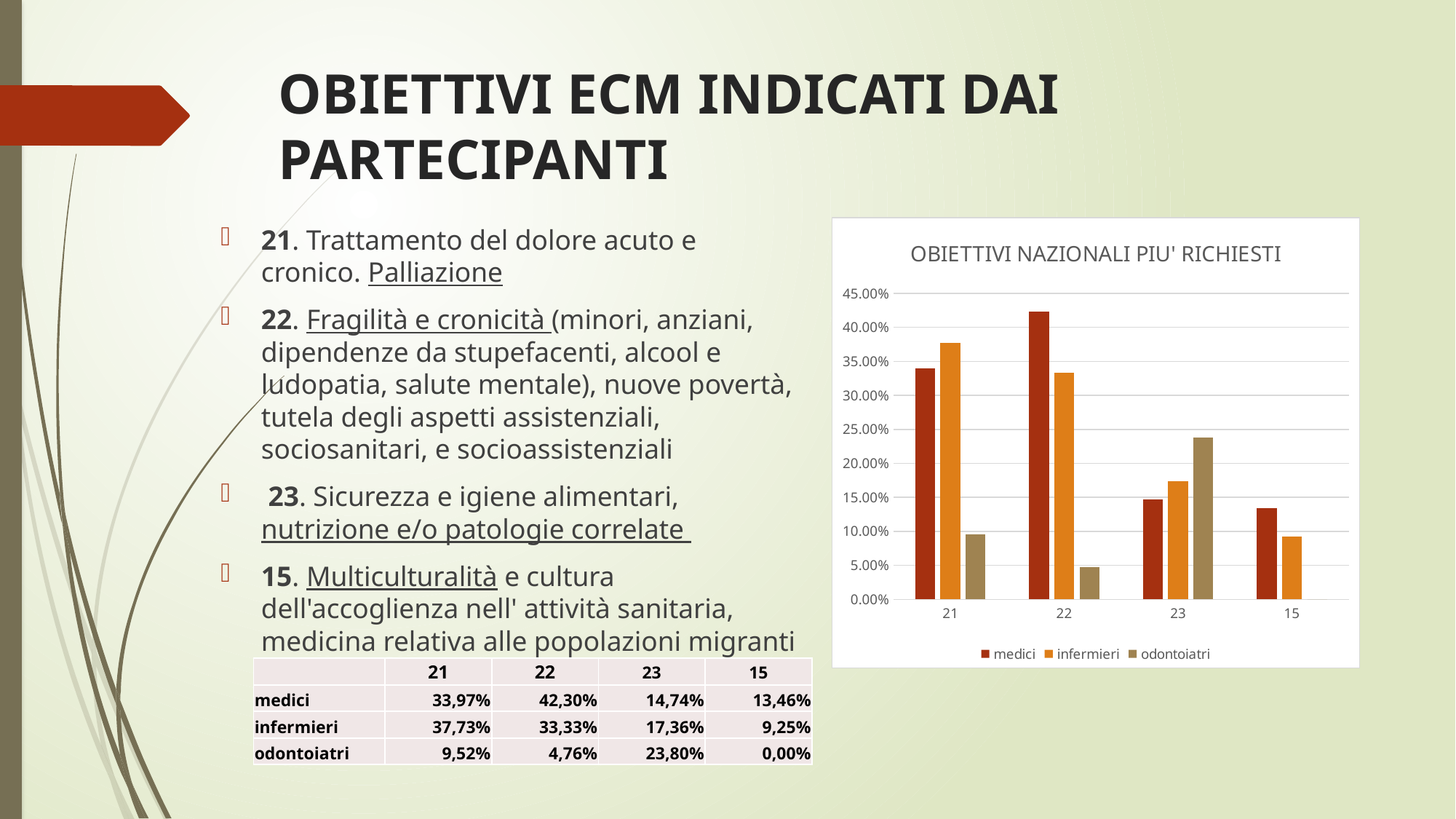
According to the table on the slide, what is the value for odontoiatri in category 23? 23,80% According to the table on the slide, what is the value for infermieri in category 21? 37,73% How many categories are shown on the x axis of the chart? 4 What is the title of the chart? OBIETTIVI NAZIONALI PIU' RICHIESTI What type of chart is shown on the slide? bar chart In category 23, which series has the larger value: medici or odontoiatri? odontoiatri Which category has the lowest value for the odontoiatri series? 15 Is the value for odontoiatri in category 22 greater or less than 5.00%? less Using the values in the table, what is the difference between medici and infermieri in category 22? 8,97% Which category has the highest value for the medici series? 22 How many series does the chart legend list? 3 Is the value for medici in category 22 greater or less than 40.00%? greater